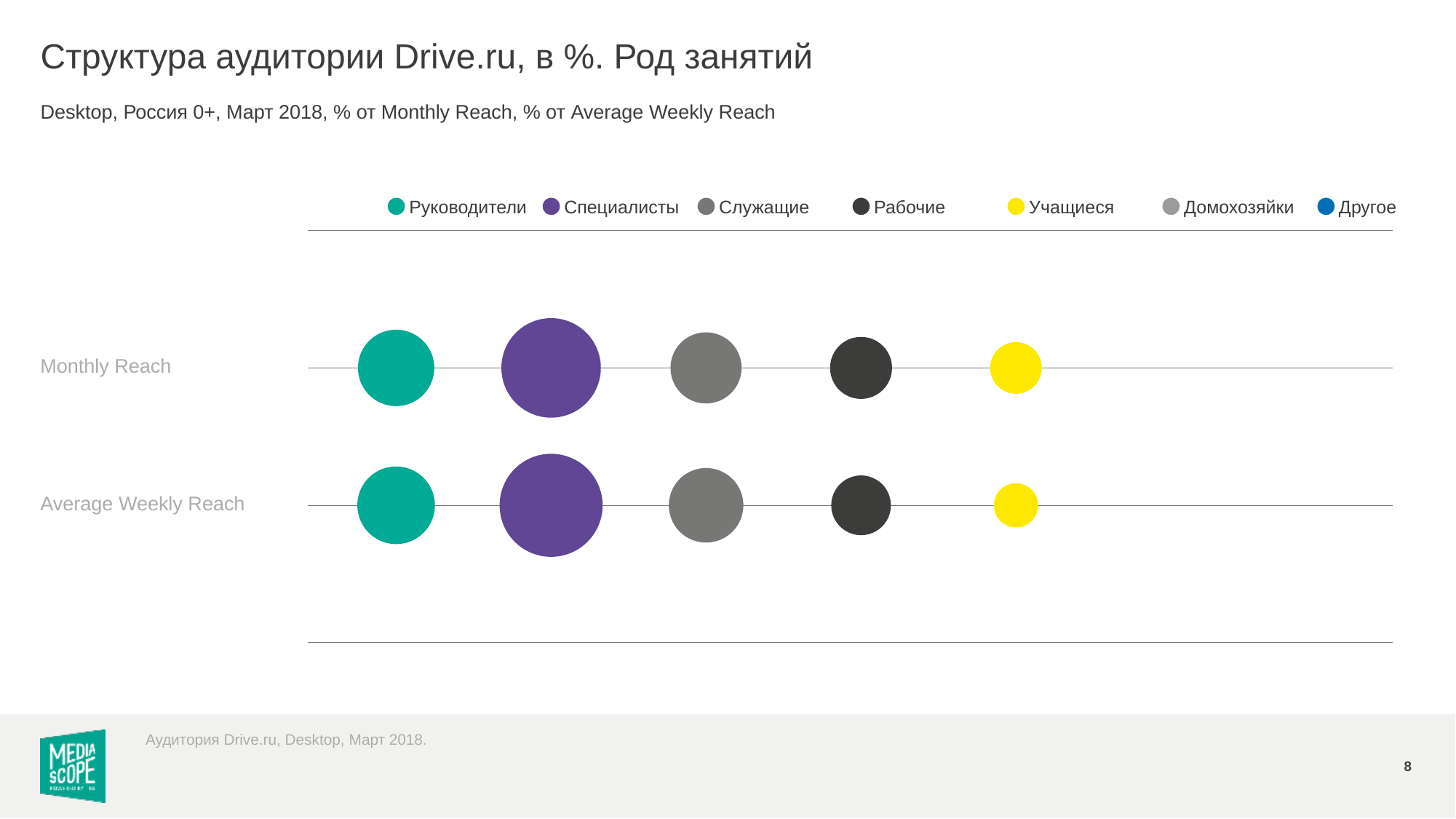
Among the bubbles visible in the Monthly Reach row, which category has the smallest bubble? Учащиеся How many rows (reach metrics) are plotted in the chart? 2 In the Monthly Reach row, which bubble is larger: Специалисты or Рабочие? Специалисты Which occupation category has the largest bubble in the Average Weekly Reach row? Специалисты What is the title of the chart on the slide? Структура аудитории Drive.ru, в %. Род занятий What colour represents Специалисты in the legend? purple In the Monthly Reach row, which bubble is larger: Служащие or Учащиеся? Служащие How many series does the legend list? 7 Which occupation category has the largest bubble in the Monthly Reach row? Специалисты In the Average Weekly Reach row, which bubble is larger: Руководители or Учащиеся? Руководители What kind of chart is shown on the slide? bubble chart